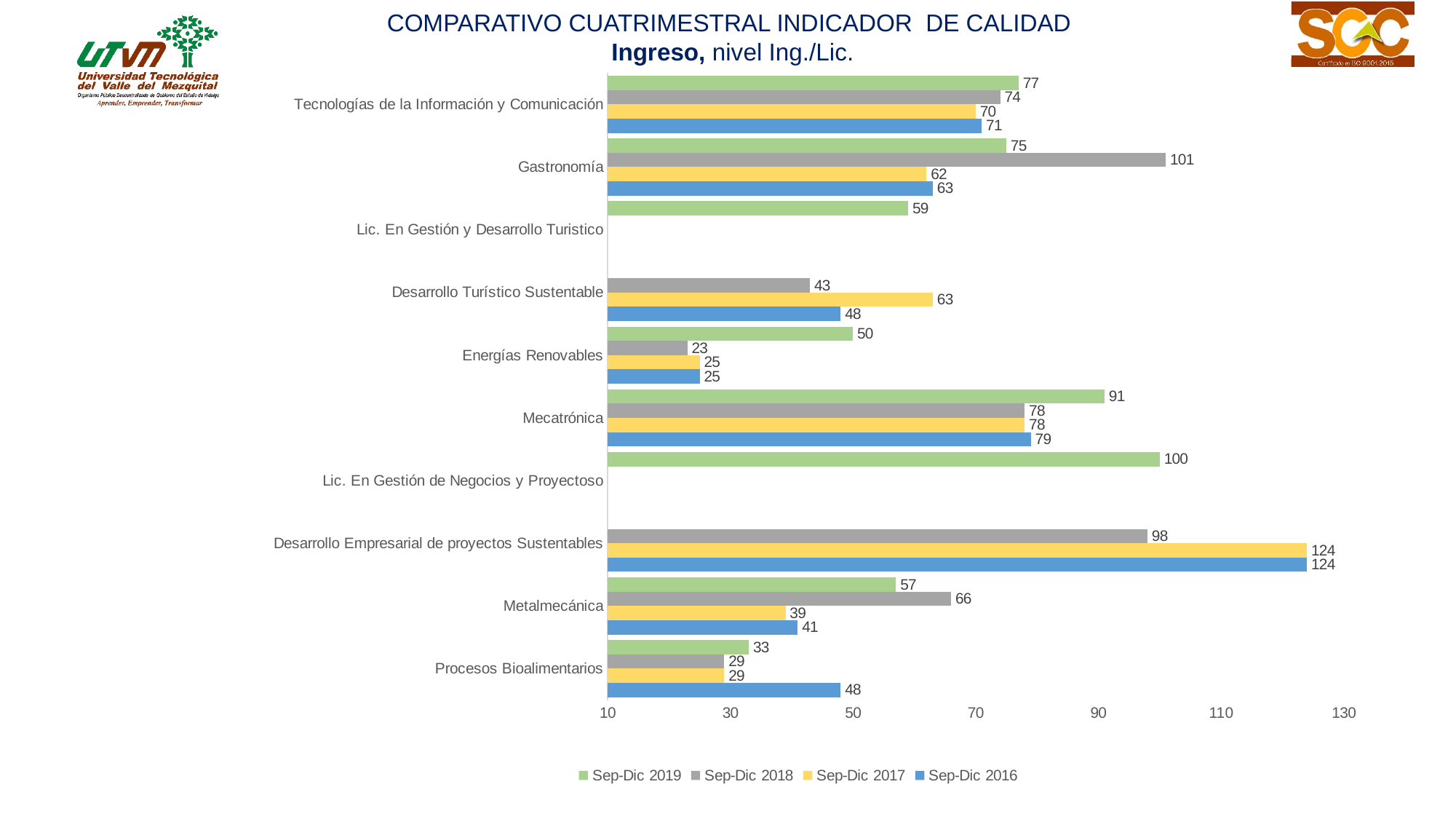
What kind of chart is shown on the slide? Bar chart What is the difference between the Sep-Dic 2018 and Sep-Dic 2019 values for Gastronomía? 26 Which category has the lowest Sep-Dic 2018 value? Energías Renovables What is the Sep-Dic 2016 value for Procesos Bioalimentarios? 48 Which category has the highest Sep-Dic 2019 value? Lic. En Gestión de Negocios y Proyectoso What is the Sep-Dic 2017 value for Desarrollo Empresarial de proyectos Sustentables? 124 What is the Sep-Dic 2018 value for Gastronomía? 101 Which colour represents the Sep-Dic 2017 series? Yellow What is the Sep-Dic 2019 value for Mecatrónica? 91 How many categories are shown on the chart? 10 How many series does the legend list? 4 Which is larger for Metalmecánica: the Sep-Dic 2019 value or the Sep-Dic 2018 value? Sep-Dic 2018